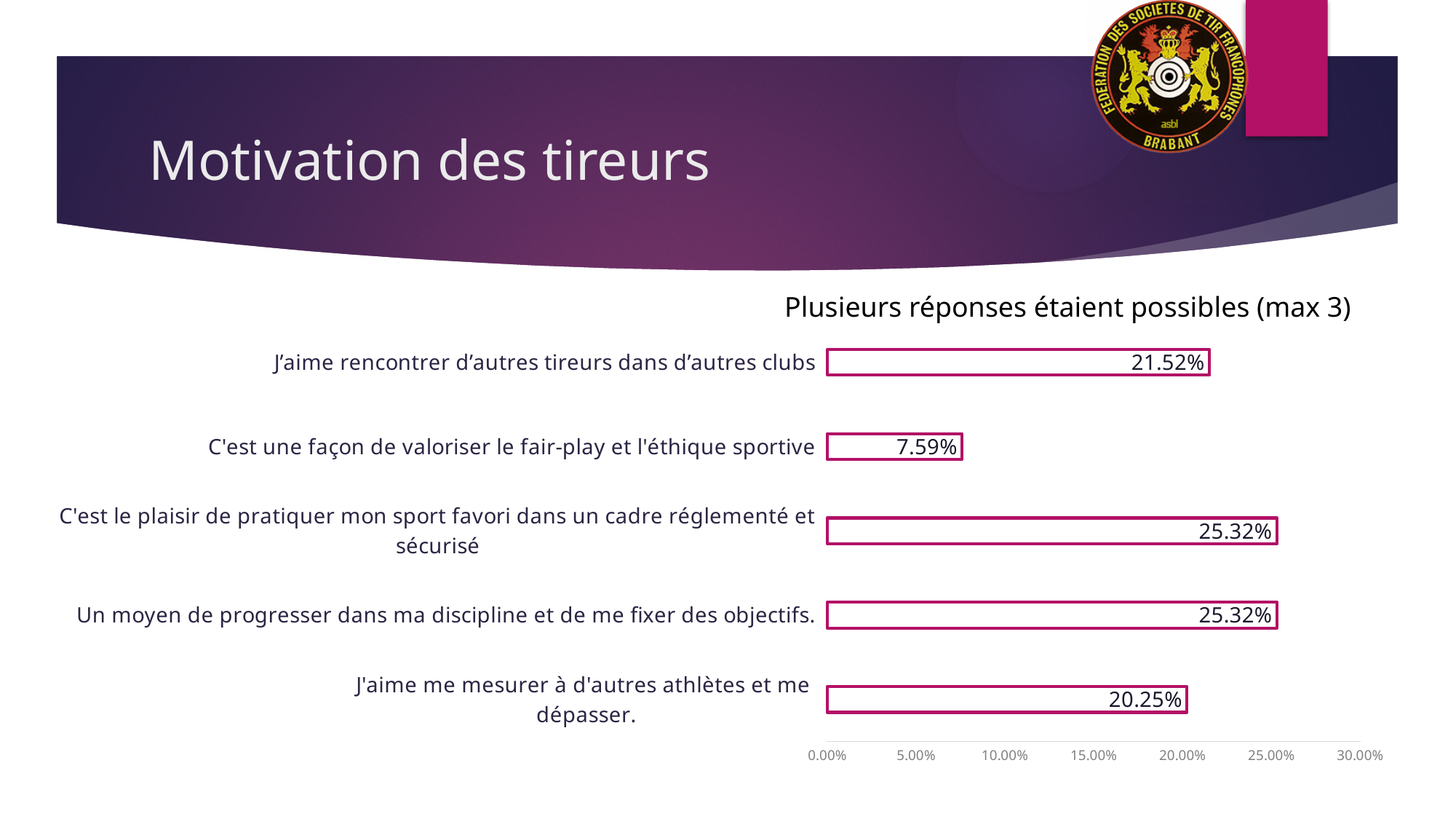
What kind of chart is shown on the slide? bar chart Which is larger: the value for "J'aime rencontrer d'autres tireurs dans d'autres clubs" or the value for "J'aime me mesurer à d'autres athlètes et me dépasser."? J'aime rencontrer d'autres tireurs dans d'autres clubs Which category has the lowest value? C'est une façon de valoriser le fair-play et l'éthique sportive What note is printed above the chart about how respondents could answer? Plusieurs réponses étaient possibles (max 3) What is the value for "J'aime me mesurer à d'autres athlètes et me dépasser."? 20.25% What is the value for "J'aime rencontrer d'autres tireurs dans d'autres clubs"? 21.52% How many categories (motivations) does the chart show? 5 Is the value for "C'est une façon de valoriser le fair-play et l'éthique sportive" greater or less than 10.00%? less What is the difference between the value for "J'aime rencontrer d'autres tireurs dans d'autres clubs" and the value for "J'aime me mesurer à d'autres athlètes et me dépasser."? 1.27% What is the value for "Un moyen de progresser dans ma discipline et de me fixer des objectifs."? 25.32% What is the value for "C'est une façon de valoriser le fair-play et l'éthique sportive"? 7.59% What is the difference between the value for "C'est le plaisir de pratiquer mon sport favori dans un cadre réglementé et sécurisé" and the value for "C'est une façon de valoriser le fair-play et l'éthique sportive"? 17.73%